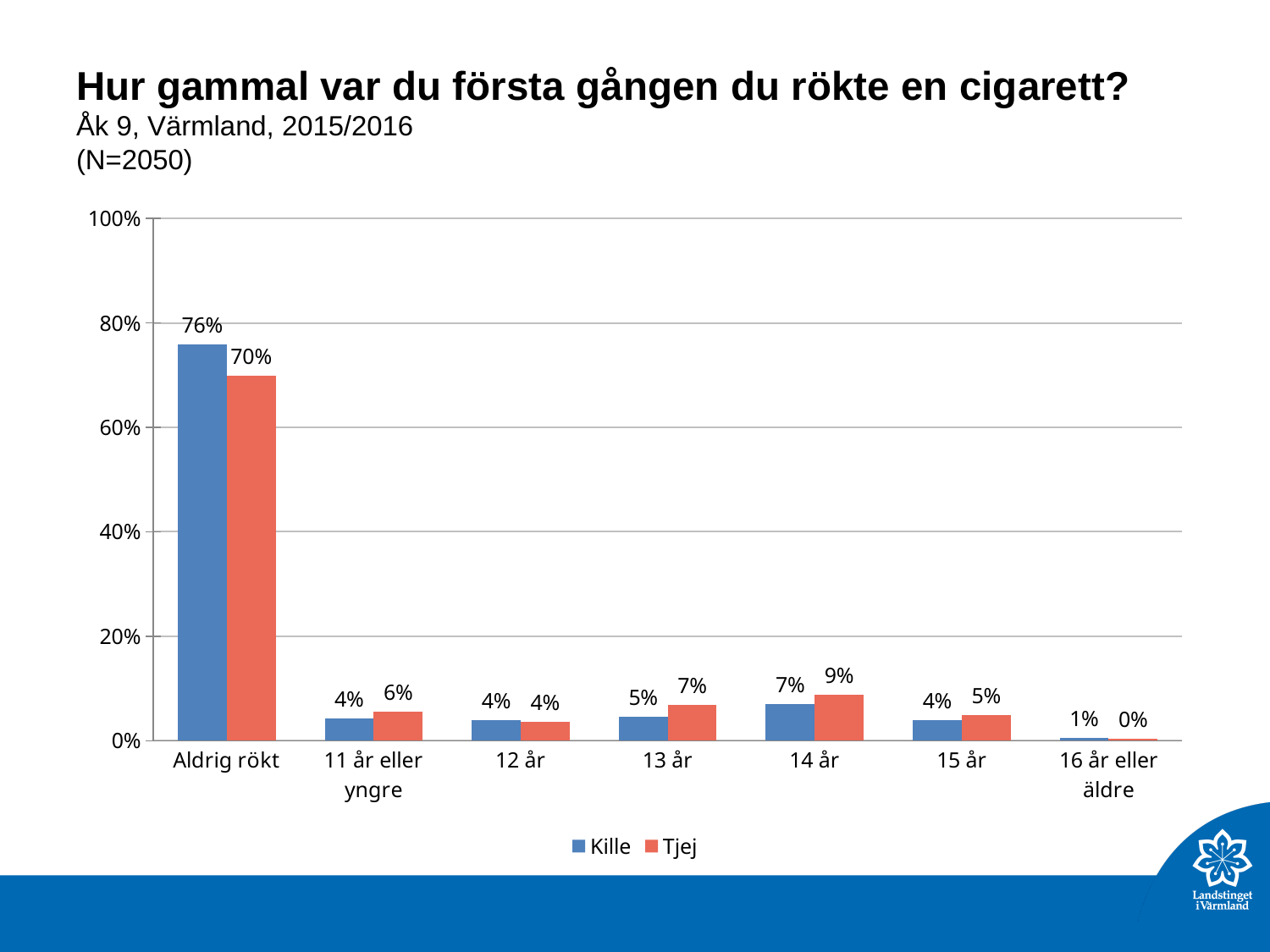
How many categories are shown on the x axis? 7 Which category has the highest value for Tjej? Aldrig rökt In the "13 år" category, which series has the larger value, Kille or Tjej? Tjej What is the value for Tjej in the "16 år eller äldre" category? 0% What is the value for Tjej in the "14 år" category? 9% What kind of chart is shown on the slide? Bar chart What is the difference between the Kille and Tjej values in the "Aldrig rökt" category? 6% Is the value for Tjej in the "Aldrig rökt" category greater or less than 60%? greater What is the sample size (N) stated on the slide? N=2050 What is the value for Kille in the "Aldrig rökt" category? 76% Which category has the lowest value for Kille? 16 år eller äldre How many series does the legend list? 2